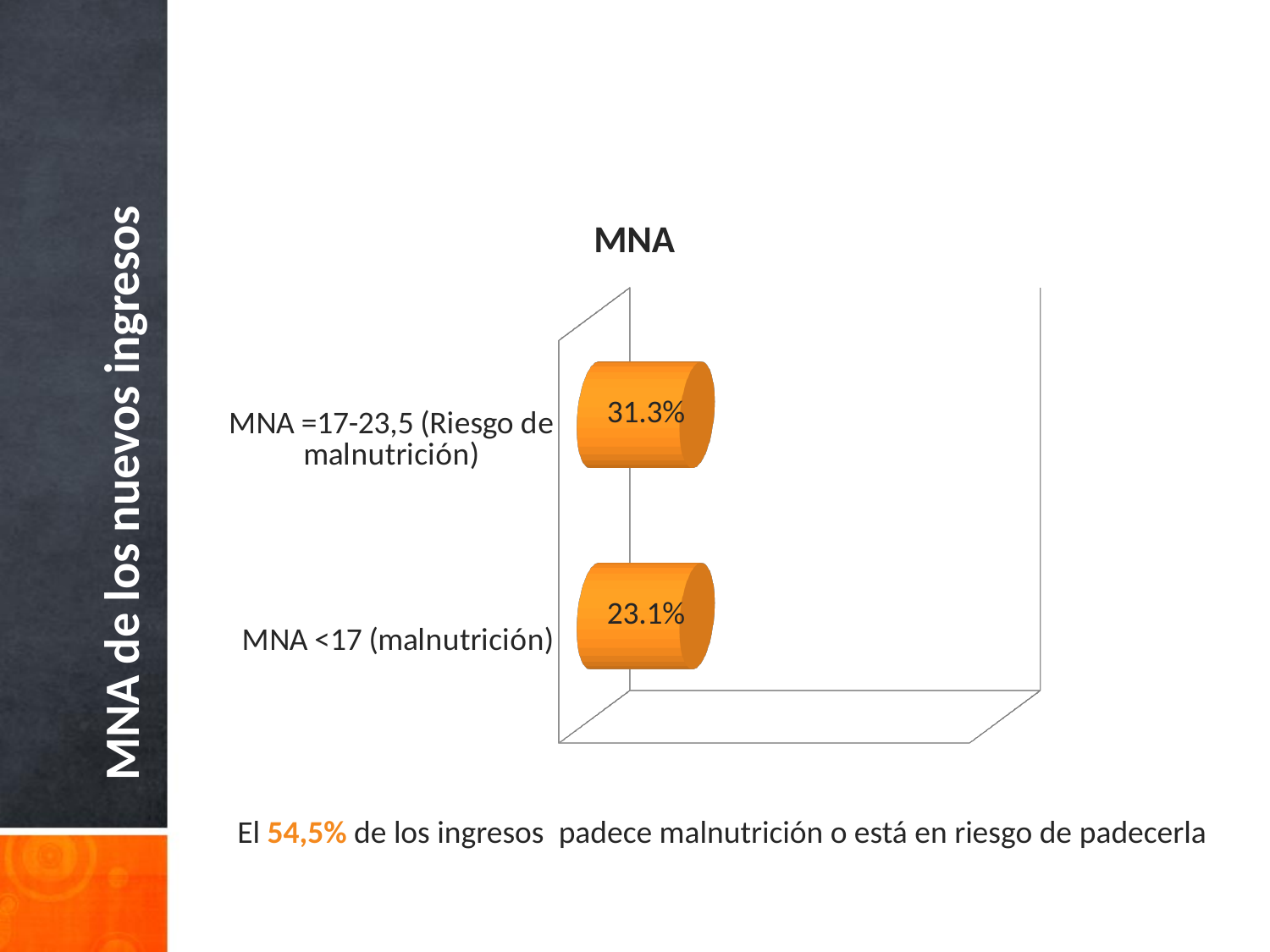
Which category has the lowest value? MNA <17 (malnutrición) What is the value for the category "MNA <17 (malnutrición)"? 23.1% What is the value for the category "MNA =17-23,5 (Riesgo de malnutrición)"? 31.3% What type of chart is shown on the slide? bar chart Which category has the highest value? MNA =17-23,5 (Riesgo de malnutrición) What colour are the bars in the chart? orange How many categories are shown in the chart? 2 What is the title of the chart? MNA What is the difference between the value for "MNA =17-23,5 (Riesgo de malnutrición)" and the value for "MNA <17 (malnutrición)"? 8.2% Which is larger: the value for "MNA <17 (malnutrición)" or the value for "MNA =17-23,5 (Riesgo de malnutrición)"? MNA =17-23,5 (Riesgo de malnutrición)